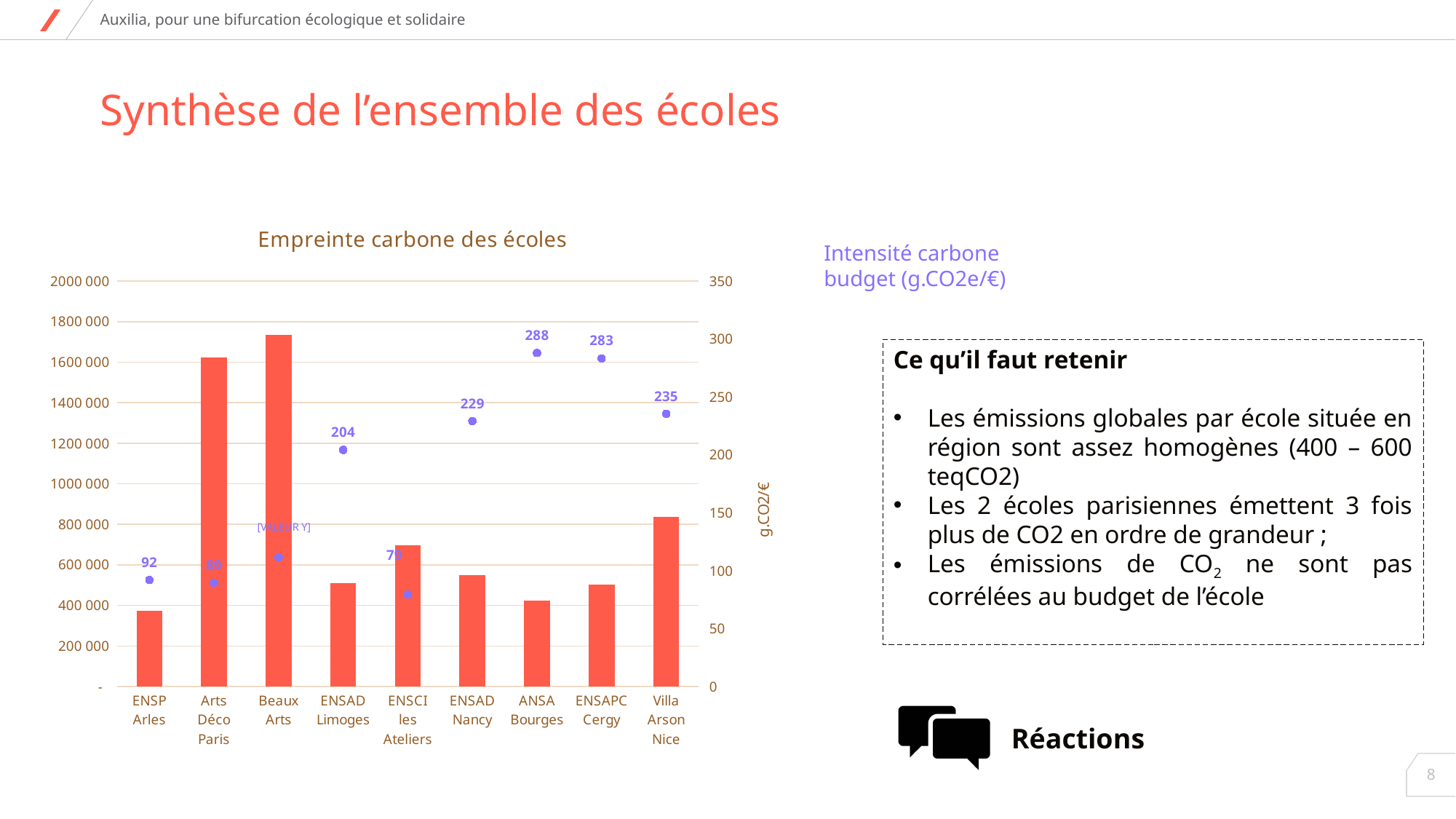
What is the carbon intensity value labelled for ENSCI les Ateliers? 79 Which school has the tallest bar for carbon footprint? Beaux Arts How many schools are shown on the x axis of the chart? 9 What is the title of the chart on the slide? Empreinte carbone des écoles Which school has the lowest labelled carbon intensity value? ENSCI les Ateliers What is the carbon intensity value labelled for ENSAD Limoges? 204 Which has a higher carbon intensity value, ENSAD Nancy or Villa Arson Nice? Villa Arson Nice What is the difference between the carbon intensity values of ANSA Bourges and ENSAPC Cergy? 5 Which school has the highest labelled carbon intensity value? ANSA Bourges What is the carbon intensity value (g.CO2/€) labelled for ANSA Bourges? 288 Is the carbon footprint bar for ENSAD Limoges greater or less than 600 000? less What type of chart is used to show the carbon footprint of the schools? bar chart